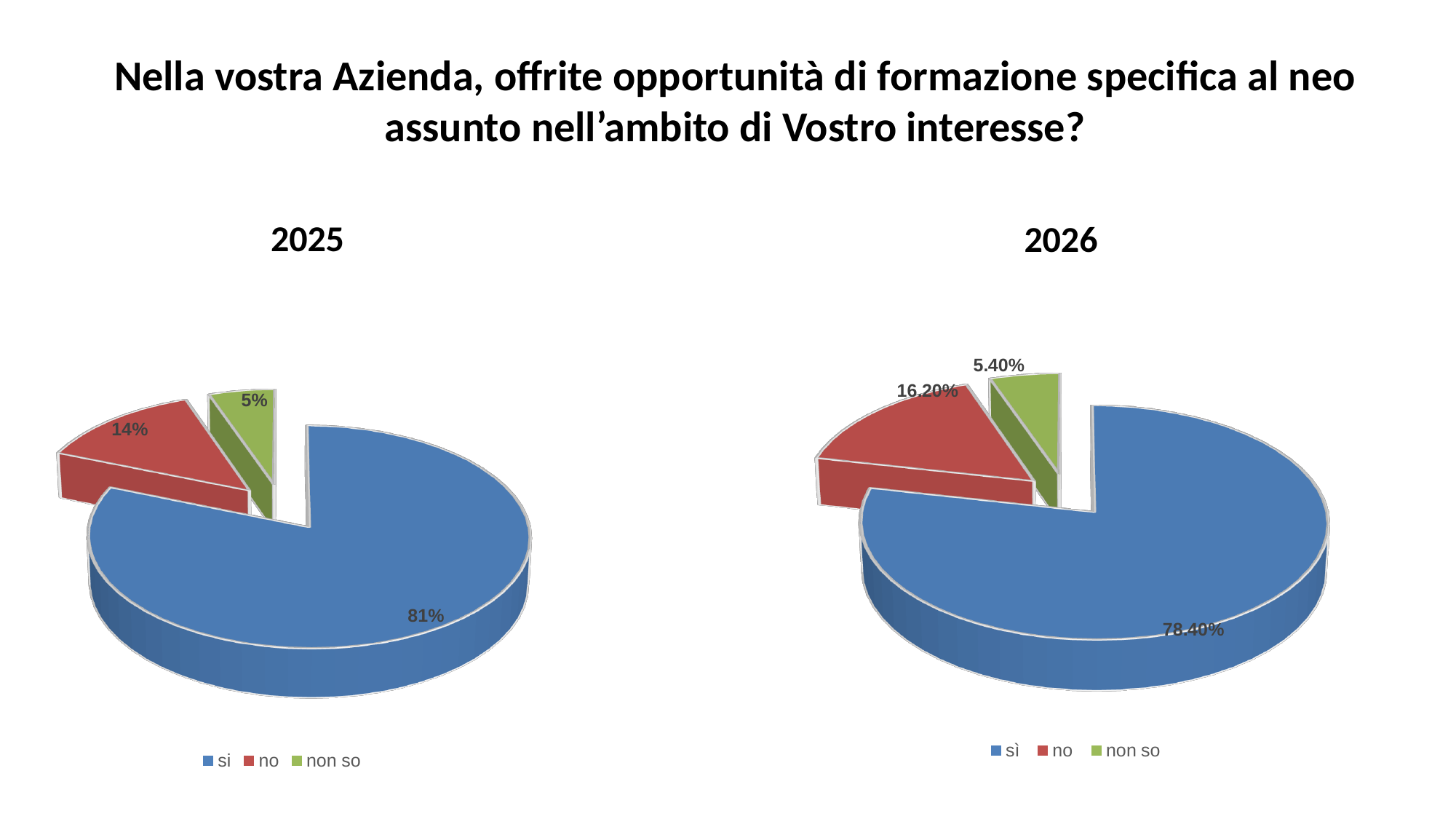
In the 2025 chart, what is the difference between the "no" share and the "non so" share? 9% In the 2026 chart, what percentage of respondents answered "sì"? 78.40% How many slices does the 2026 chart have? 3 In the 2025 chart, what percentage of respondents answered "si"? 81% In the 2025 chart, which answer has the largest share? si In the 2026 chart, what percentage of respondents answered "no"? 16.20% In the 2025 chart, what percentage of respondents answered "no"? 14% Is the "no" share larger in the 2025 chart or in the 2026 chart? 2026 What type of chart is the 2025 chart? Pie chart In the 2026 chart, which answer has the smallest share? non so In the 2026 chart, what percentage of respondents answered "non so"? 5.40% In the 2025 chart, what percentage of respondents answered "non so"? 5%